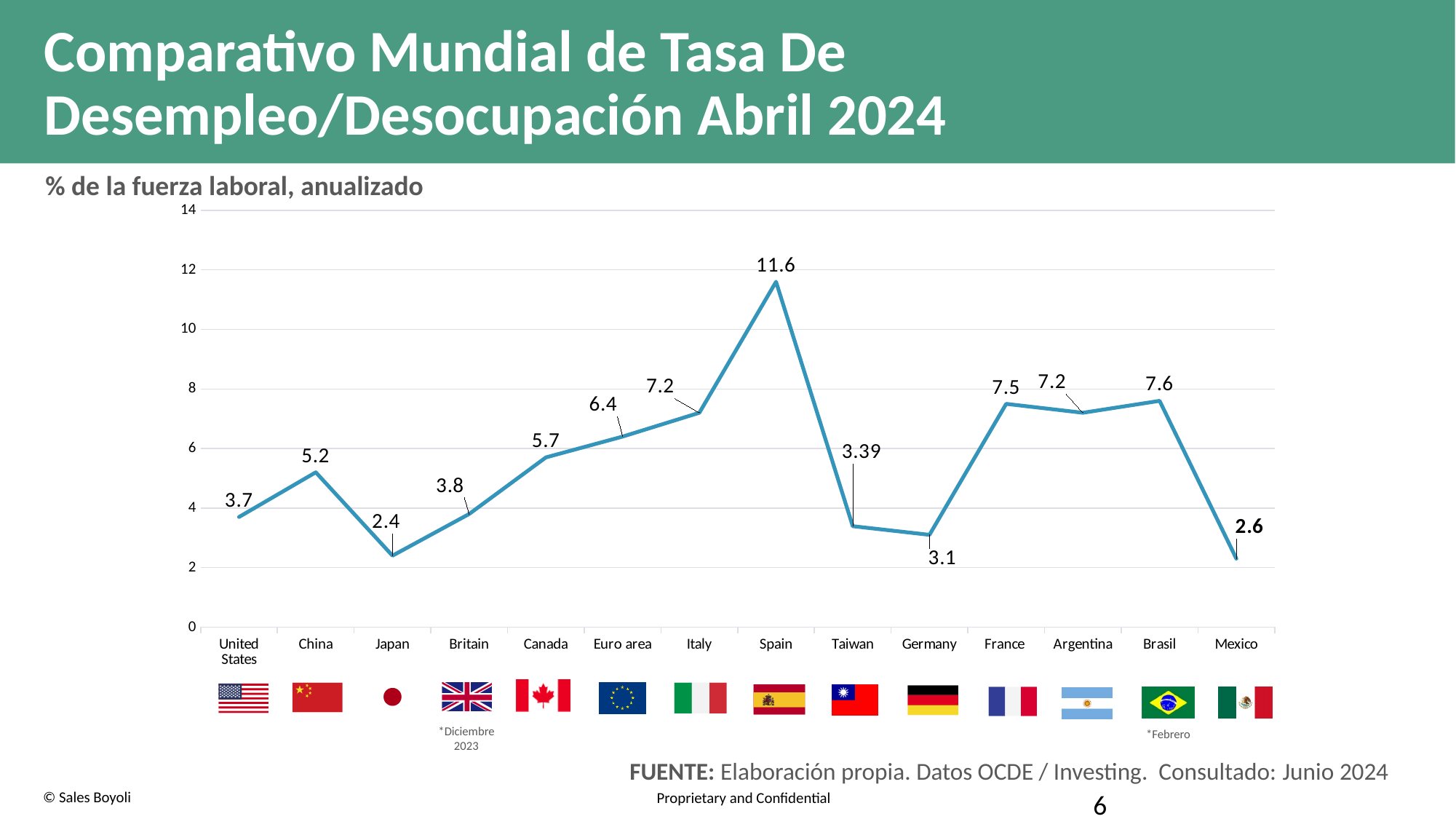
What type of chart is shown on the slide? Line chart What is the subtitle describing the unit of the chart? % de la fuerza laboral, anualizado What is the unemployment rate shown for Taiwan? 3.39 What is the difference between the unemployment rates of Brasil and France? 0.1 What is the difference between the unemployment rates of Spain and Japan? 9.2 How many countries or regions are plotted on the chart? 14 Which country has the highest unemployment rate on the chart? Spain What is the unemployment rate shown for Spain? 11.6 What is the unemployment rate shown for Mexico? 2.6 Is the value for Euro area greater or less than 6? greater Which has a higher unemployment rate, China or Canada? Canada